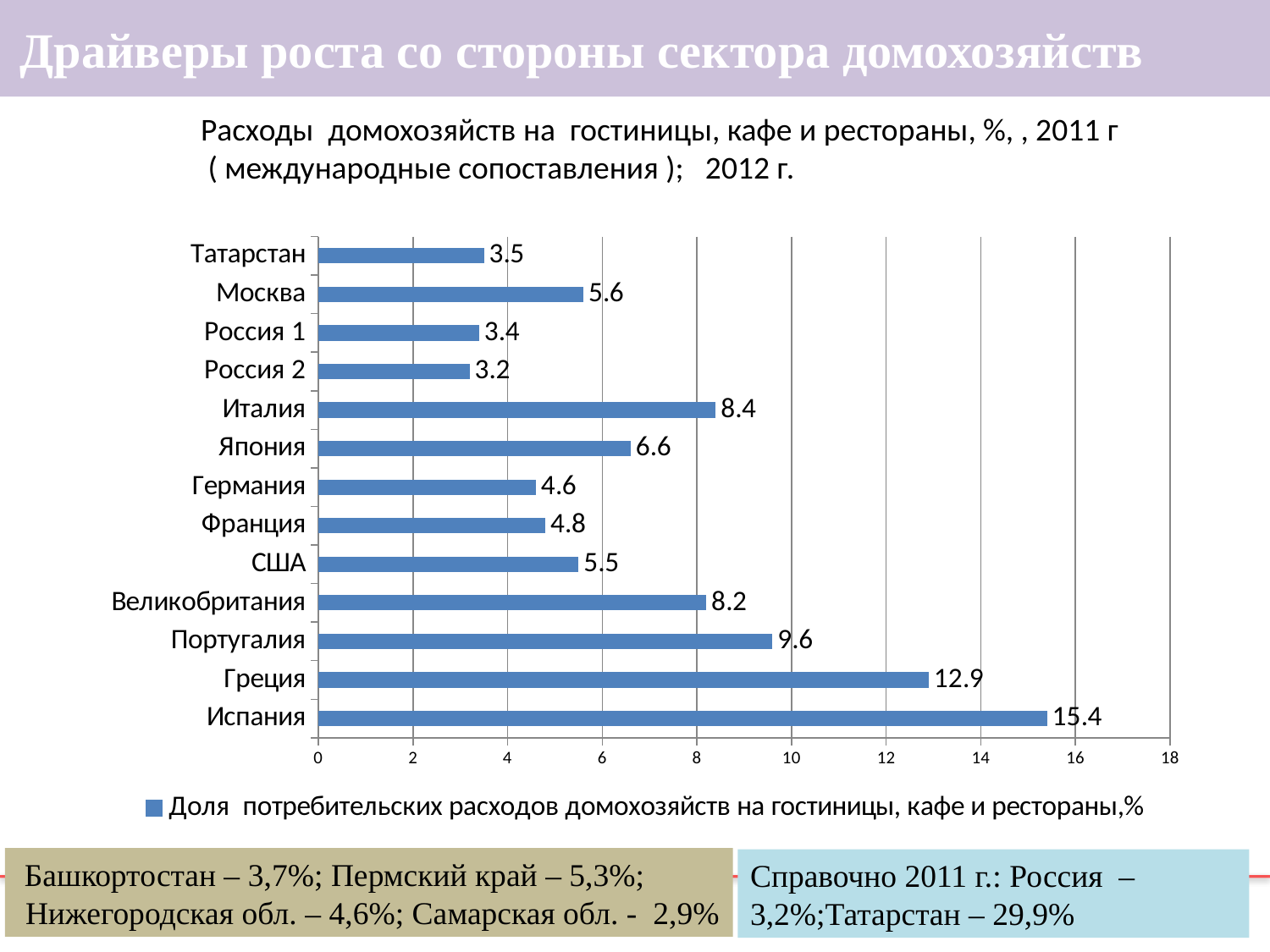
Which category has the lowest value? Россия 2 Is the value for Великобритания greater or less than 8? greater What is the difference between the values for Греция and Португалия? 3.3 Which is larger, the value for Москва or the value for США? Москва What is the value for Татарстан? 3.5 What is the value for Испания? 15.4 What is the legend entry for the series? Доля потребительских расходов домохозяйств на гостиницы, кафе и рестораны,% What is the value for Япония? 6.6 Which category has the highest value? Испания How many categories are shown on the chart? 13 How many series does the legend list? 1 What kind of chart is shown? bar chart